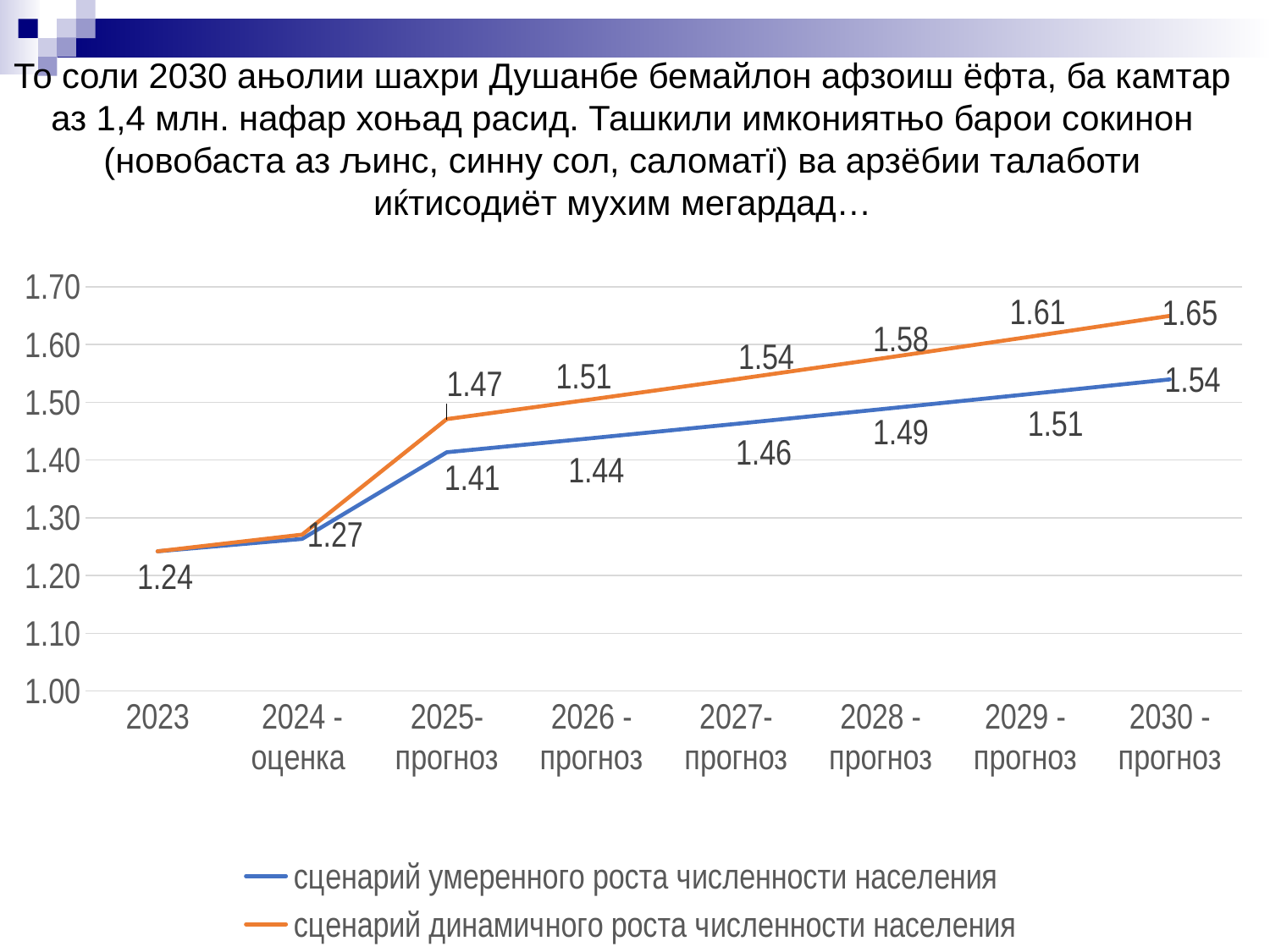
What is the value for the dynamic growth scenario (сценарий динамичного роста численности населения) at 2030 - прогноз? 1.65 What is the value for the moderate growth scenario at 2025- прогноз? 1.41 What is the value for the moderate growth scenario (сценарий умеренного роста численности населения) at 2030 - прогноз? 1.54 What kind of chart is shown on the slide? line chart Which colour is used for the line of the moderate growth scenario (сценарий умеренного роста численности населения)? blue How many points are on the x axis of the chart? 8 What is the difference between the dynamic growth scenario and the moderate growth scenario at 2030 - прогноз? 0.11 What is the difference between the dynamic growth scenario and the moderate growth scenario at 2025- прогноз? 0.06 How many series does the legend list? 2 Which series has the higher value at 2028 - прогноз? сценарий динамичного роста численности населения What value is labelled at 2023? 1.24 Do the values of the dynamic growth scenario rise or fall from 2023 to 2030 - прогноз? rise